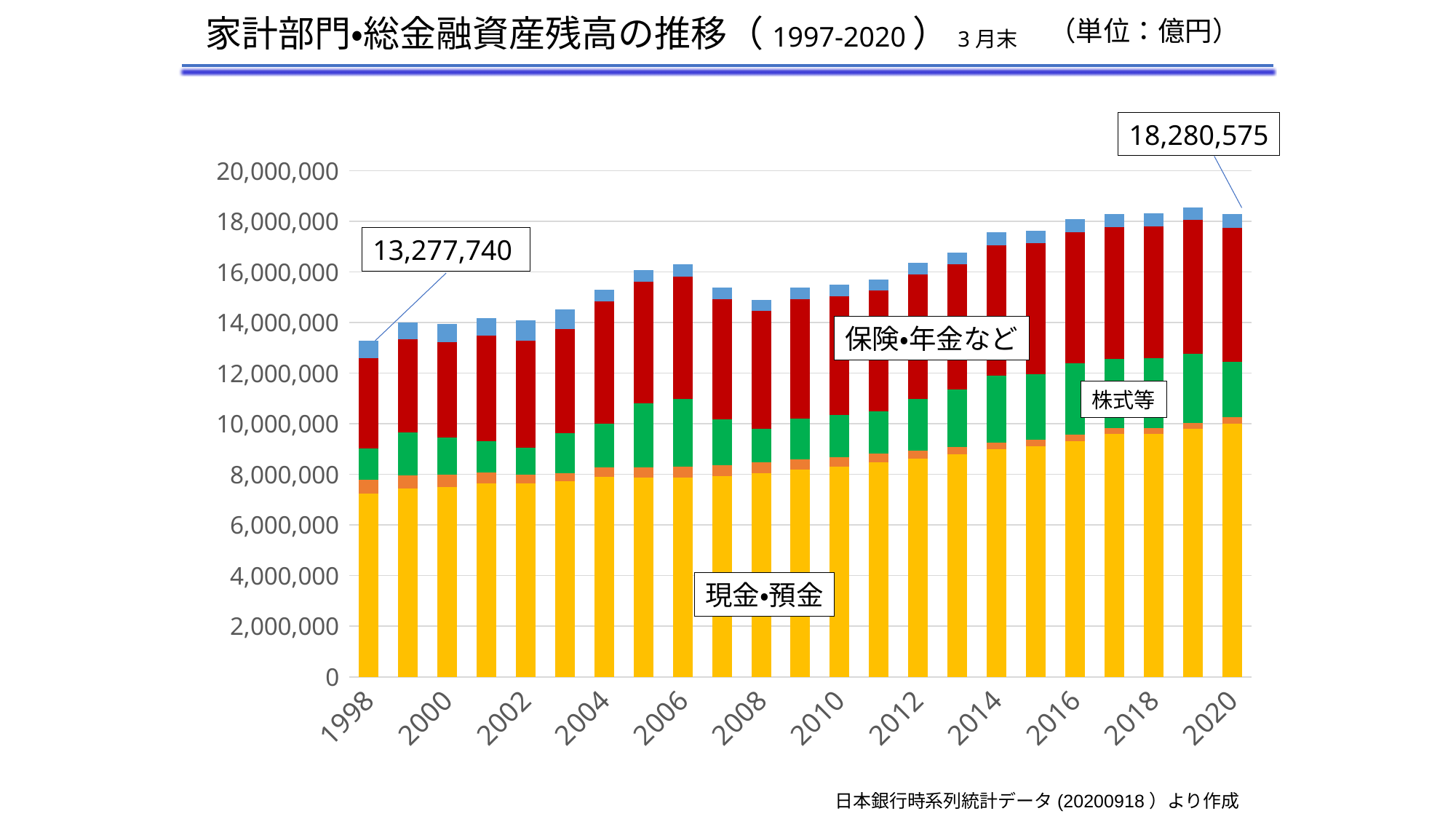
What is the difference between the labelled totals for 2020 and 1998? 5,002,835 Is the total for 2010 greater or less than 16,000,000? less Is the total for 2019 greater or less than 18,000,000? greater What is the total household financial asset balance labelled for 2020? 18,280,575 Is the 現金•預金 segment for 1998 greater or less than 8,000,000? less How many years (bars) are plotted on the chart? 23 What kind of chart is shown on the slide? stacked bar chart Which year has the lowest total bar? 1998 What unit is stated for the values on the chart? 億円 What is the total household financial asset balance labelled for 1998? 13,277,740 Do the total bars generally rise or fall from 1998 to 2020? rise Which year has the highest total bar? 2019